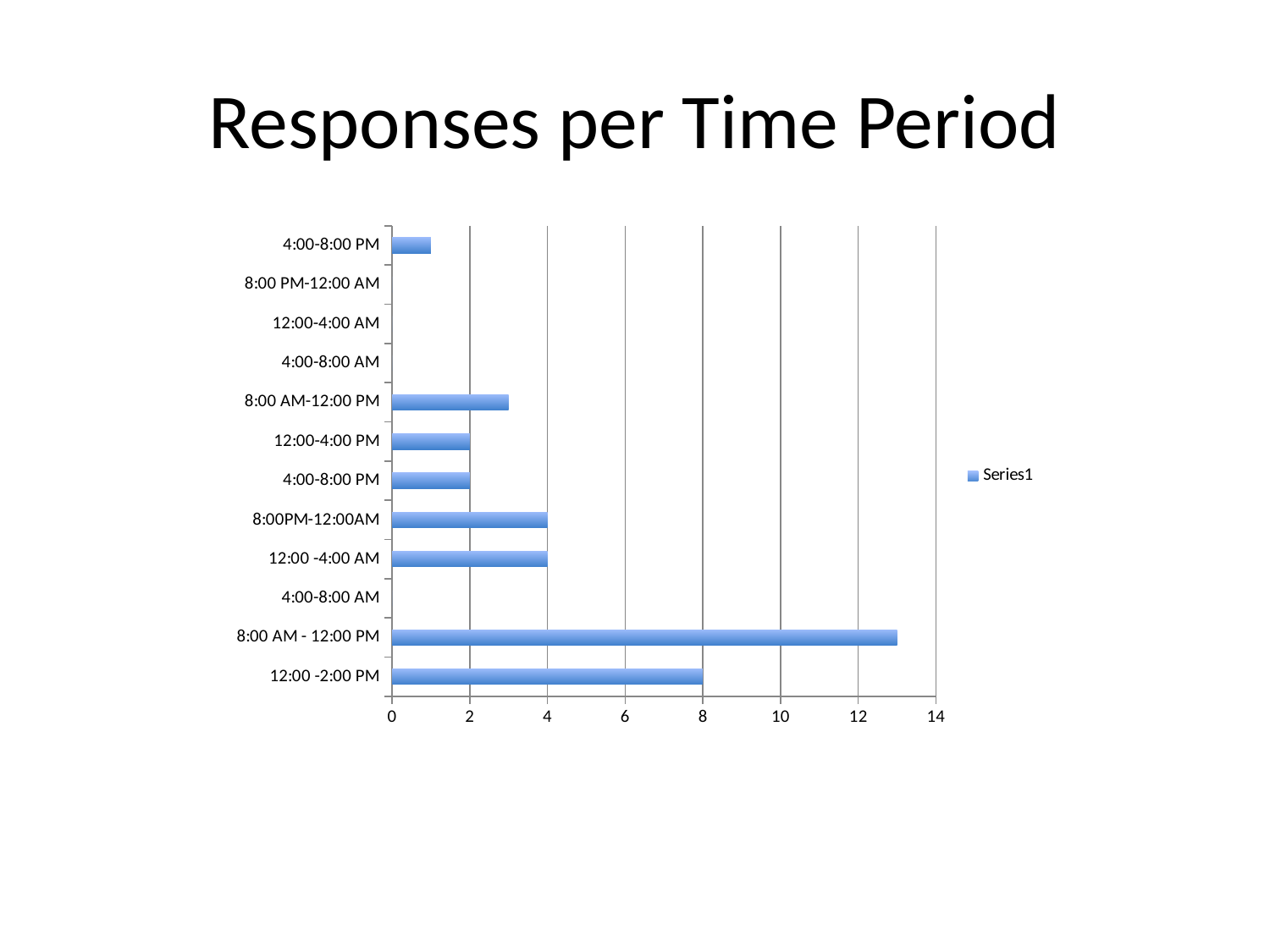
What is the name of the series shown in the legend? Series1 What is the title of the chart? Responses per Time Period What is the value for the bottom category, 12:00 -2:00 PM? 8 Is the value for 8:00 AM - 12:00 PM (second bar from the bottom) greater or less than 12? greater Which has a larger value: 12:00 -2:00 PM or 8:00PM-12:00AM? 12:00 -2:00 PM What is the value for the category 12:00-4:00 PM? 2 How many series does the legend list? 1 How many categories (time periods) are listed on the vertical axis of the chart? 12 Is the value for the 8:00 AM-12:00 PM bar that is fifth from the top greater or less than 4? less Which time period has the highest number of responses? 8:00 AM - 12:00 PM What kind of chart is shown on the slide? bar chart What is the value for the category 8:00PM-12:00AM? 4